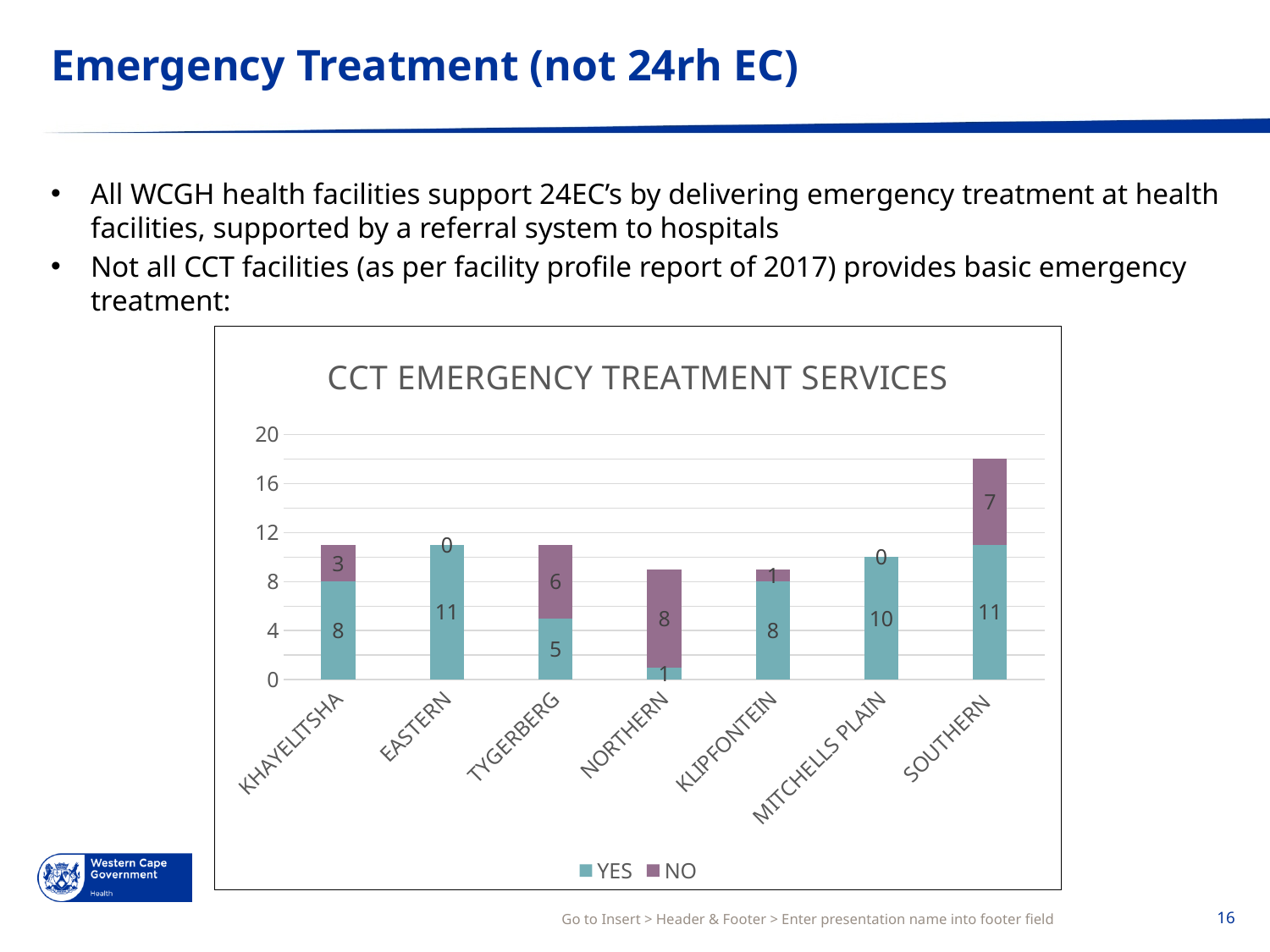
Which category has the lowest YES value? NORTHERN What is the NO value for SOUTHERN? 7 What is the NO value for NORTHERN? 8 What type of chart is shown on the slide? Stacked bar chart Which category has the highest NO value? NORTHERN What is the title of the chart? CCT EMERGENCY TREATMENT SERVICES How many series does the legend list? 2 How many categories are shown on the x axis? 7 Which is larger, the YES value for MITCHELLS PLAIN or the YES value for KLIPFONTEIN? MITCHELLS PLAIN What is the difference between the YES values for EASTERN and KHAYELITSHA? 3 What is the total of the stacked bar for SOUTHERN? 18 What is the YES value for TYGERBERG? 5